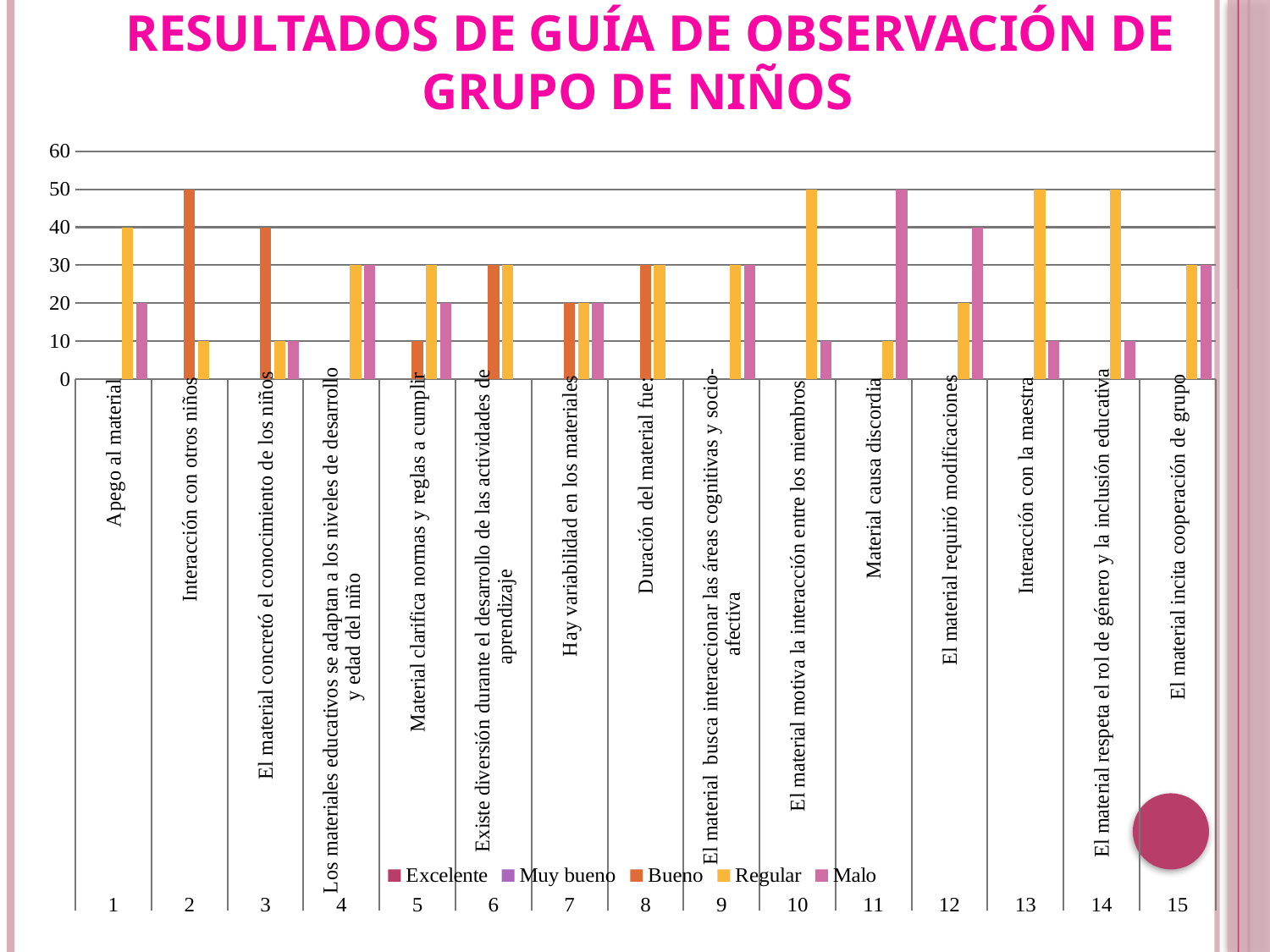
Is the Bueno value for 'El material concretó el conocimiento de los niños' greater or less than 30? greater Which series has the highest value for 'Interacción con la maestra'? Regular What is the value of the Bueno series for 'Interacción con otros niños'? 50 What is the value of the Regular series for 'Apego al material'? 40 What is the value of the Malo series for 'El material requirió modificaciones'? 40 How many series does the legend list? 5 What is the title of the slide? RESULTADOS DE GUÍA DE OBSERVACIÓN DE GRUPO DE NIÑOS What kind of chart is shown on the slide? bar chart What is the difference between the Regular value and the Malo value for 'El material motiva la interacción entre los miembros'? 40 How many categories are shown along the x axis? 15 What is the value of the Malo series for 'Material causa discordia'? 50 For 'Apego al material', which is larger: the Regular value or the Malo value? Regular